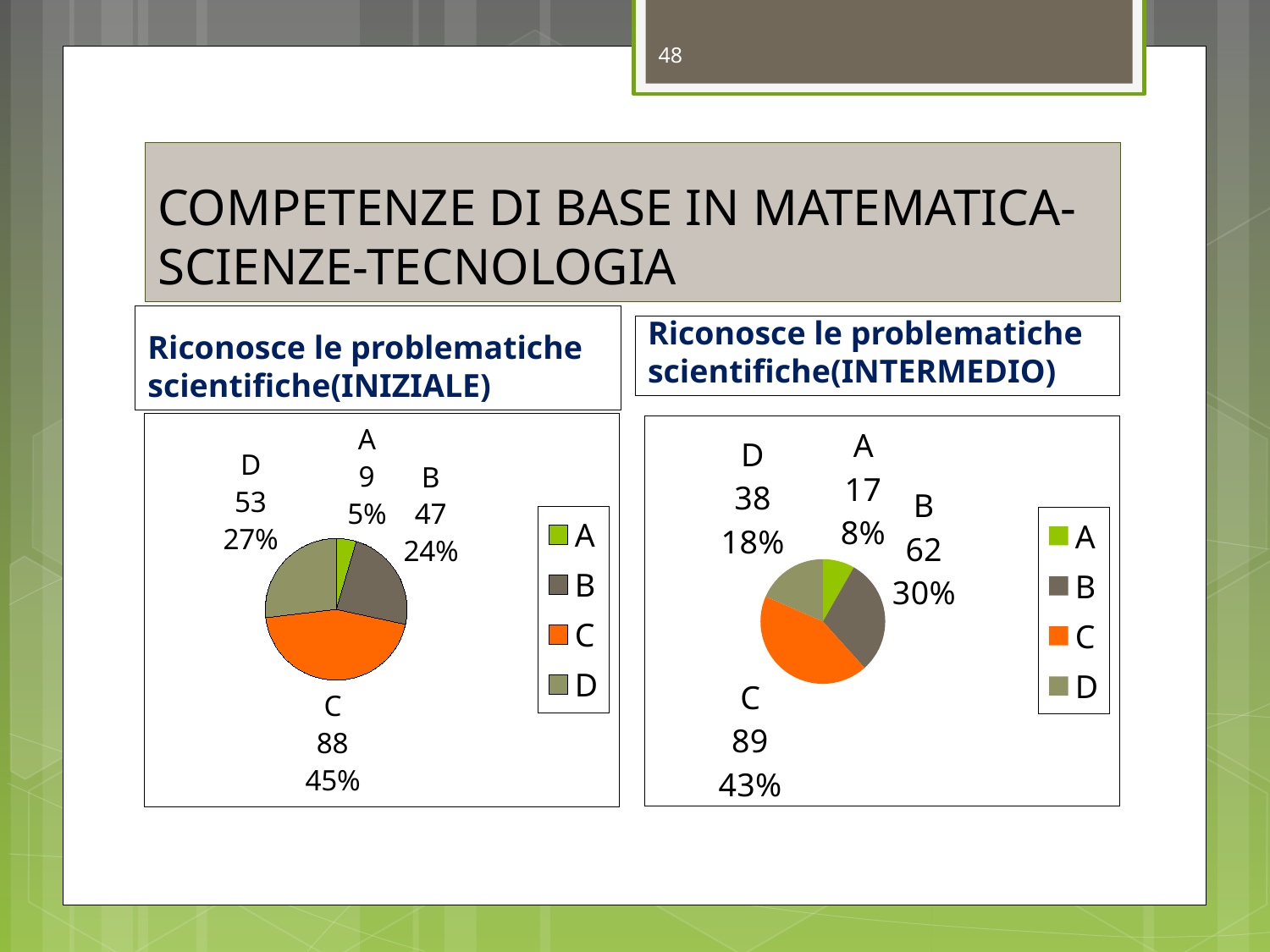
In the INIZIALE pie chart, what colour represents category C in the legend? Orange In the INTERMEDIO pie chart, what is the difference between the values for B and D? 24 In the INTERMEDIO pie chart, which is larger, the value for B or the value for D? B In the INIZIALE pie chart, which category has the largest value? C In the INTERMEDIO pie chart, which category has the smallest value? A In the INTERMEDIO pie chart, what is the value for category B? 62 In the INIZIALE pie chart, what is the value for category C? 88 In the INIZIALE pie chart, what is the difference between the values for C and D? 35 In the INIZIALE pie chart, what share of the pie does category D have? 27% What type of chart is used for 'Riconosce le problematiche scientifiche(INTERMEDIO)'? Pie chart In the INTERMEDIO pie chart, what share of the pie does category A have? 8% How many categories does the INIZIALE pie chart show? 4